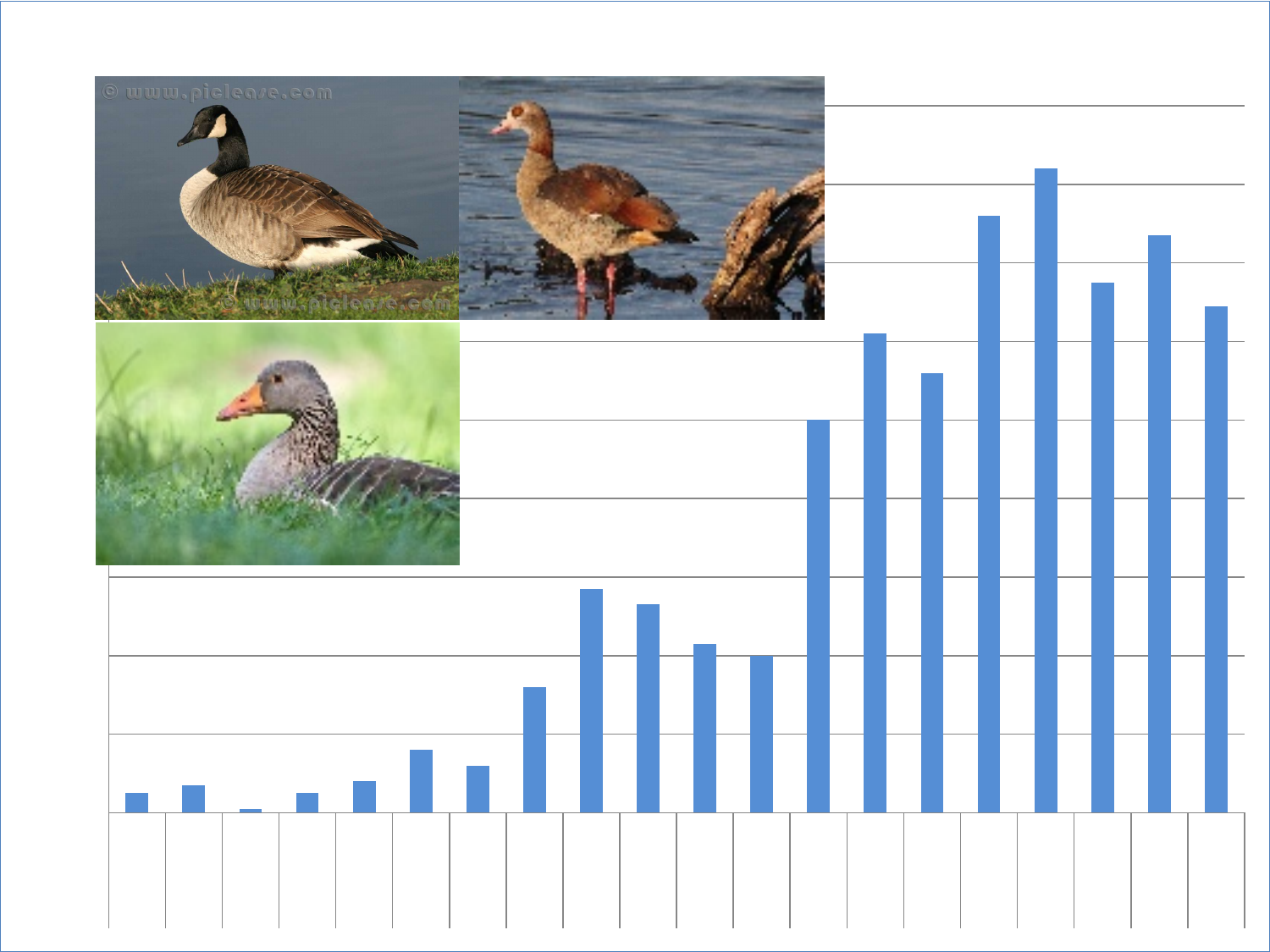
Counting from the left, which bar is the tallest in the chart? the 17th bar Which is taller, the 6th bar from the left or the 7th bar from the left? the 6th bar Which is taller, the 9th bar from the left or the 10th bar from the left? the 9th bar What kind of chart is shown on the slide? bar chart Which is taller, the 13th bar from the left or the 14th bar from the left? the 14th bar What colour are the bars in the chart? blue How many data series are plotted in the chart? 1 Do the bar values generally rise or fall from left to right across the chart? rise How many bars are plotted in the chart? 20 Counting from the left, which bar is the shortest in the chart? the 3rd bar